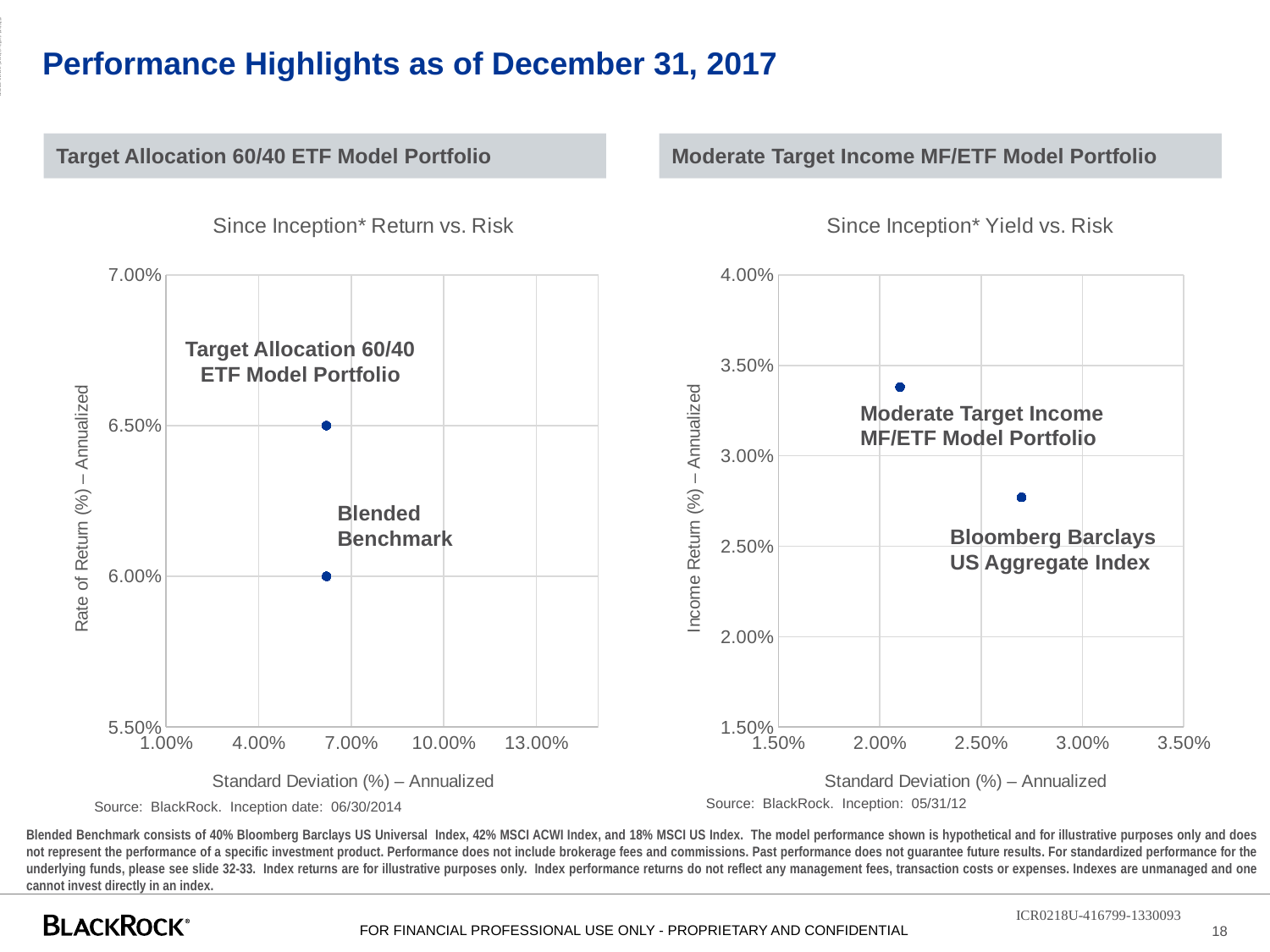
What kind of chart is the left chart titled 'Since Inception* Return vs. Risk'? scatter chart In the left chart (Since Inception* Return vs. Risk), how many data points are plotted? 2 In the left chart (Since Inception* Return vs. Risk), which has the higher rate of return: the Target Allocation 60/40 ETF Model Portfolio or the Blended Benchmark? Target Allocation 60/40 ETF Model Portfolio In the right chart (Since Inception* Yield vs. Risk), is the standard deviation for the Bloomberg Barclays US Aggregate Index greater or less than 2.50%? greater In the right chart (Since Inception* Yield vs. Risk), is the standard deviation for the Moderate Target Income MF/ETF Model Portfolio greater or less than 2.50%? less In the right chart (Since Inception* Yield vs. Risk), is the income return for the Bloomberg Barclays US Aggregate Index greater or less than 3.00%? less In the right chart (Since Inception* Yield vs. Risk), how many data points are plotted? 2 In the right chart (Since Inception* Yield vs. Risk), which has the higher income return: the Moderate Target Income MF/ETF Model Portfolio or the Bloomberg Barclays US Aggregate Index? Moderate Target Income MF/ETF Model Portfolio In the left chart (Since Inception* Return vs. Risk), what is the label of the x axis? Standard Deviation (%) – Annualized What is the title of the right chart on the slide? Since Inception* Yield vs. Risk